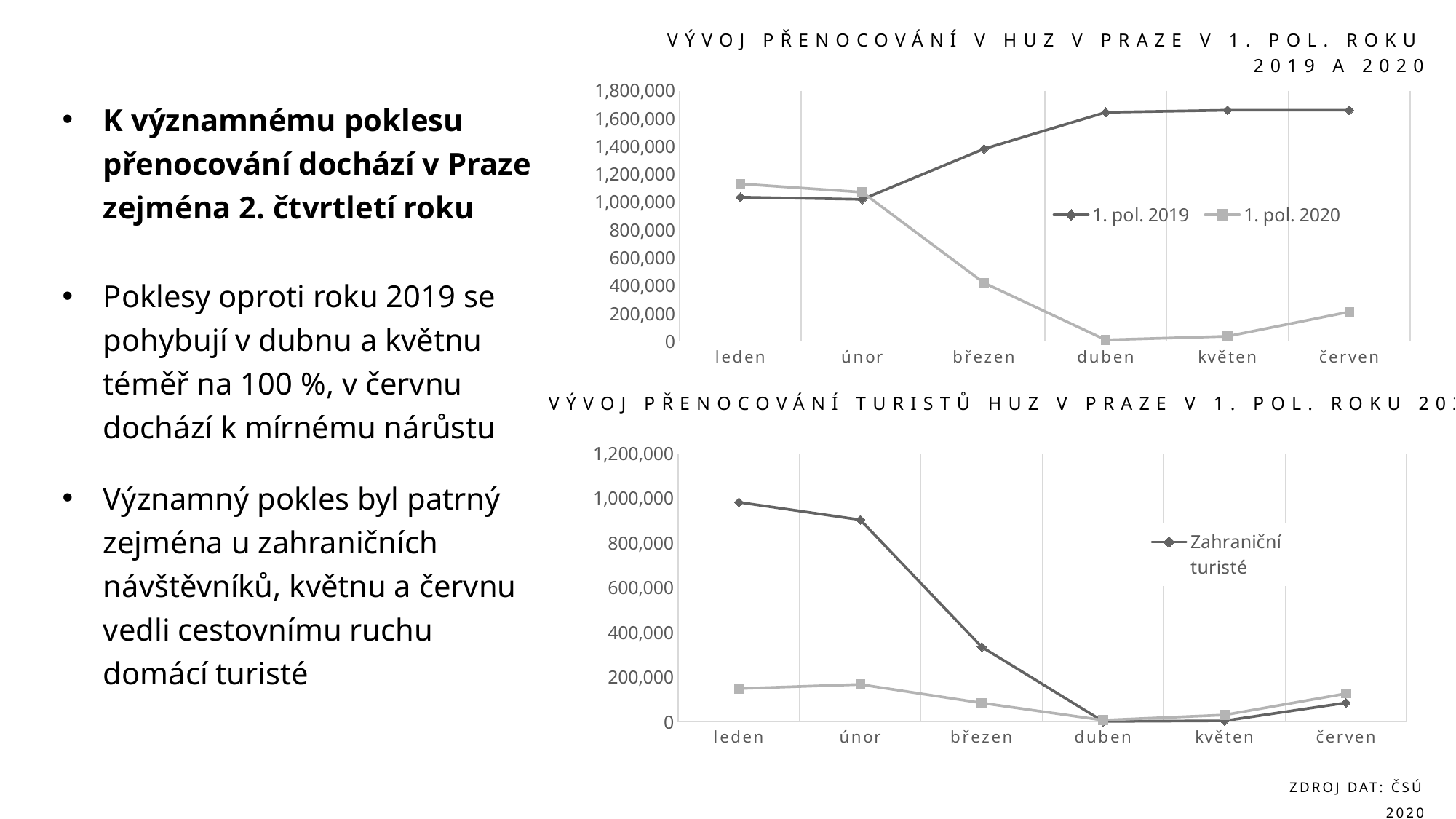
In the top chart, does the 1. pol. 2019 series rise or fall from únor to duben? Rises In the top chart, is the value for 1. pol. 2019 in duben greater or less than 1,400,000? greater In the top chart, how many series does the legend list? 2 In the top chart, how many months are shown on the x axis? 6 In the bottom chart, in which month is the value for Zahraniční turisté highest? leden In the top chart, is the value for 1. pol. 2020 in duben greater or less than 200,000? less In the bottom chart, is the value for Zahraniční turisté in březen greater or less than 400,000? less What kind of chart is the top chart, 'Vývoj přenocování v HUZ v Praze v 1. pol. roku 2019 a 2020'? Line chart In the top chart, which two series are listed in the legend? 1. pol. 2019 and 1. pol. 2020 In the top chart, does the 1. pol. 2020 series rise or fall from leden to duben? Falls In the top chart, which series has the higher value in březen, 1. pol. 2019 or 1. pol. 2020? 1. pol. 2019